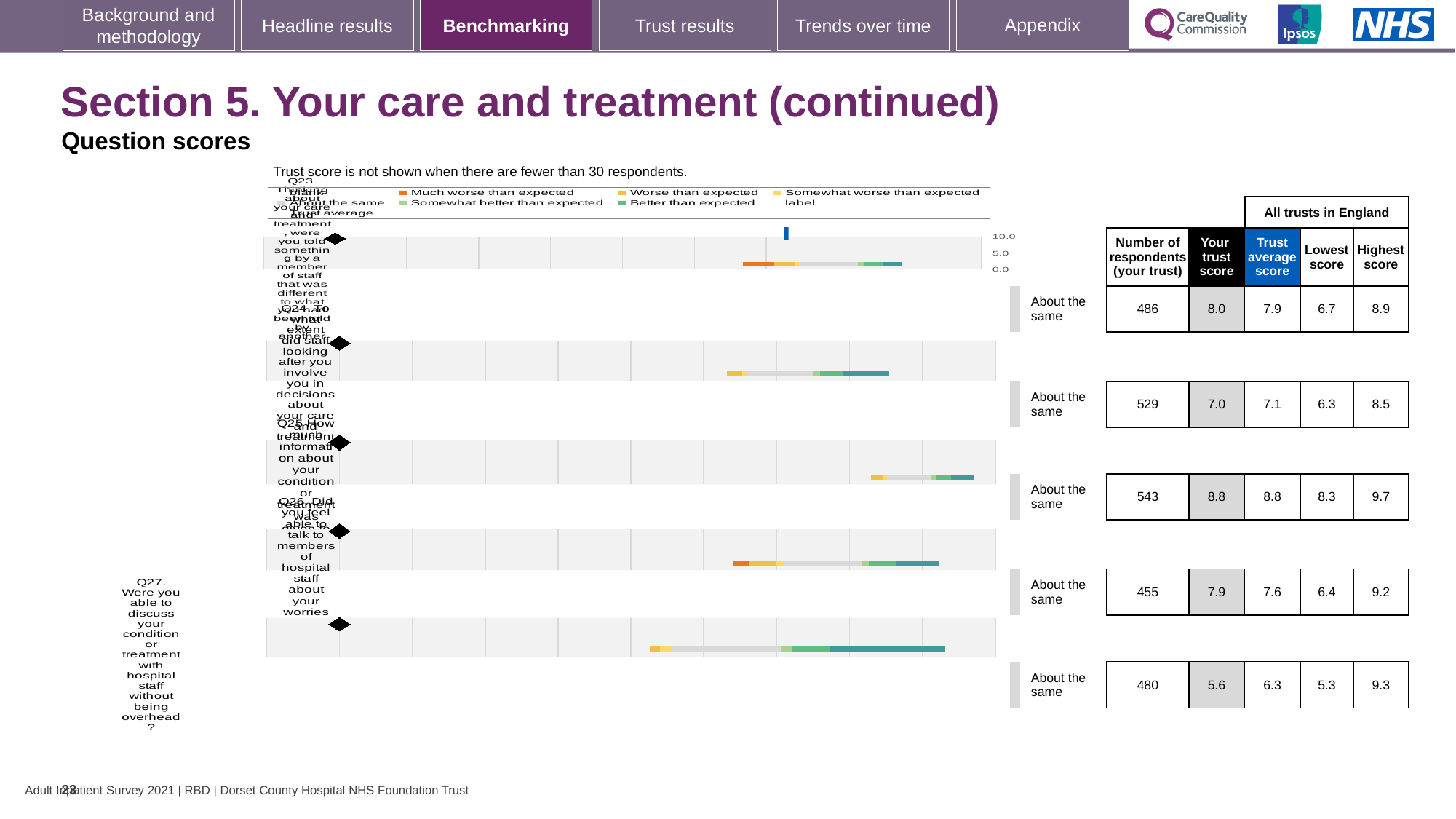
What is the 'Your trust score' for Q27 (discussing your condition or treatment without being overheard)? 5.6 What is the highest score across all trusts in England for Q24 (involving you in decisions about your care and treatment)? 8.5 For Q26 (talking to hospital staff about your worries), which is larger: your trust score or the trust average score? Your trust score For Q25, what is the difference between the highest score and the lowest score across all trusts in England? 1.4 Which question has the lowest 'Your trust score' in the table? Q27 What is the lowest score across all trusts in England for Q26? 6.4 How many questions are shown on this slide? 5 What benchmark category is shown for Q23? About the same For Q27, how much higher is the trust average score than your trust score? 0.7 Below how many respondents is the trust score not shown? 30 How many respondents answered Q25 (how much information about your condition or treatment was given)? 543 Which question has the highest 'Your trust score' in the table? Q25